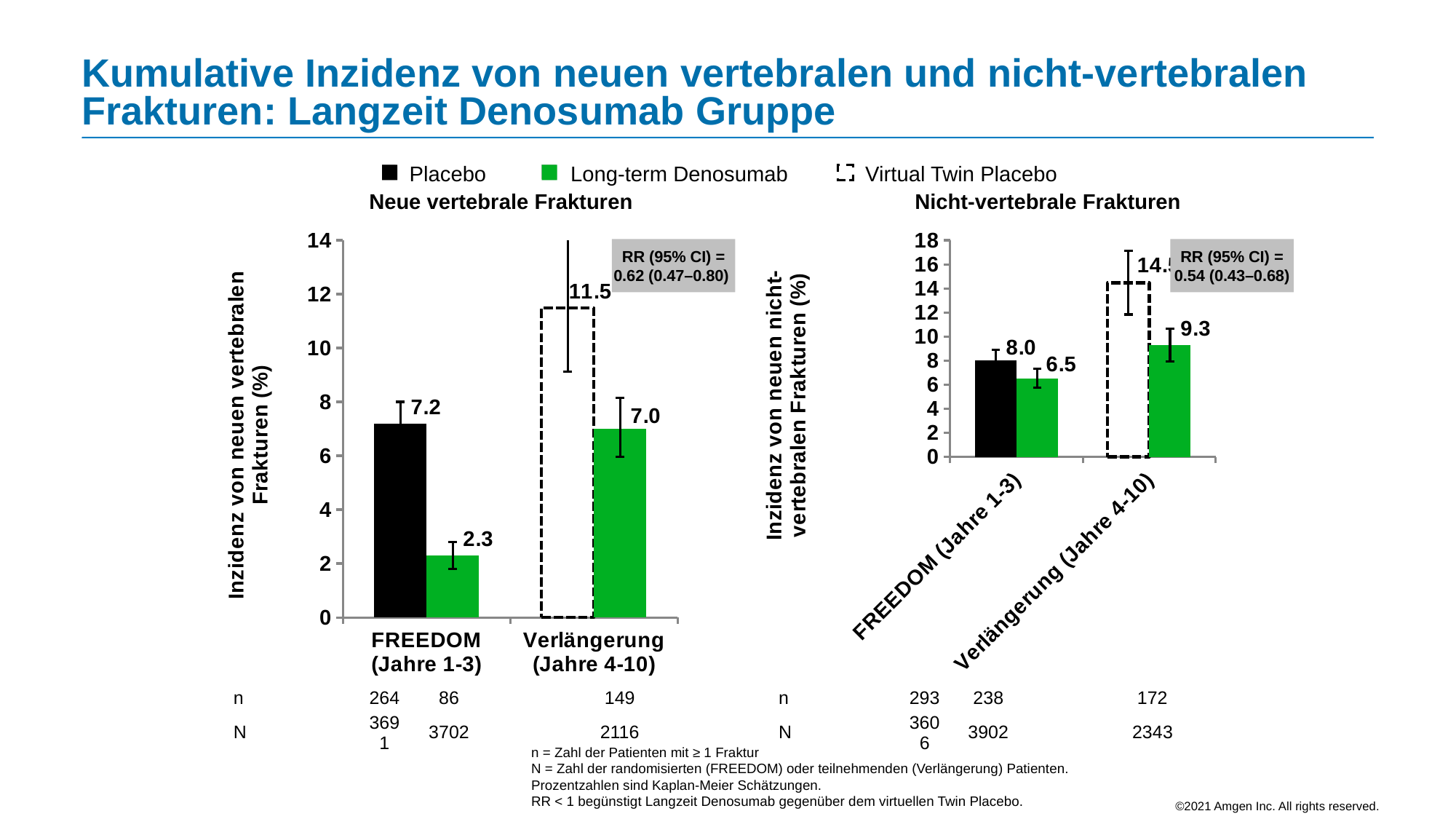
In the 'Neue vertebrale Frakturen' chart, which bar is the highest? Virtual Twin Placebo in Verlängerung (Jahre 4-10) What kind of chart is the 'Nicht-vertebrale Frakturen' chart? bar chart In the 'Neue vertebrale Frakturen' chart, what is the value for Virtual Twin Placebo in Verlängerung (Jahre 4-10)? 11.5 How many series does the legend list? 3 In the 'Nicht-vertebrale Frakturen' chart, is the value for Long-term Denosumab in FREEDOM (Jahre 1-3) larger or smaller than the Placebo value in the same period? smaller In the 'Nicht-vertebrale Frakturen' chart, what is the value for Long-term Denosumab in Verlängerung (Jahre 4-10)? 9.3 In the 'Neue vertebrale Frakturen' chart, what is the value for Long-term Denosumab in Verlängerung (Jahre 4-10)? 7.0 In the 'Neue vertebrale Frakturen' chart, what is the difference between the Placebo and Long-term Denosumab values in FREEDOM (Jahre 1-3)? 4.9 In the 'Neue vertebrale Frakturen' chart, what is the value for Placebo in FREEDOM (Jahre 1-3)? 7.2 In the 'Neue vertebrale Frakturen' chart, what is the value for Long-term Denosumab in FREEDOM (Jahre 1-3)? 2.3 In the 'Nicht-vertebrale Frakturen' chart, what is the difference between the Placebo and Long-term Denosumab values in FREEDOM (Jahre 1-3)? 1.5 In the 'Nicht-vertebrale Frakturen' chart, what is the value for Placebo in FREEDOM (Jahre 1-3)? 8.0